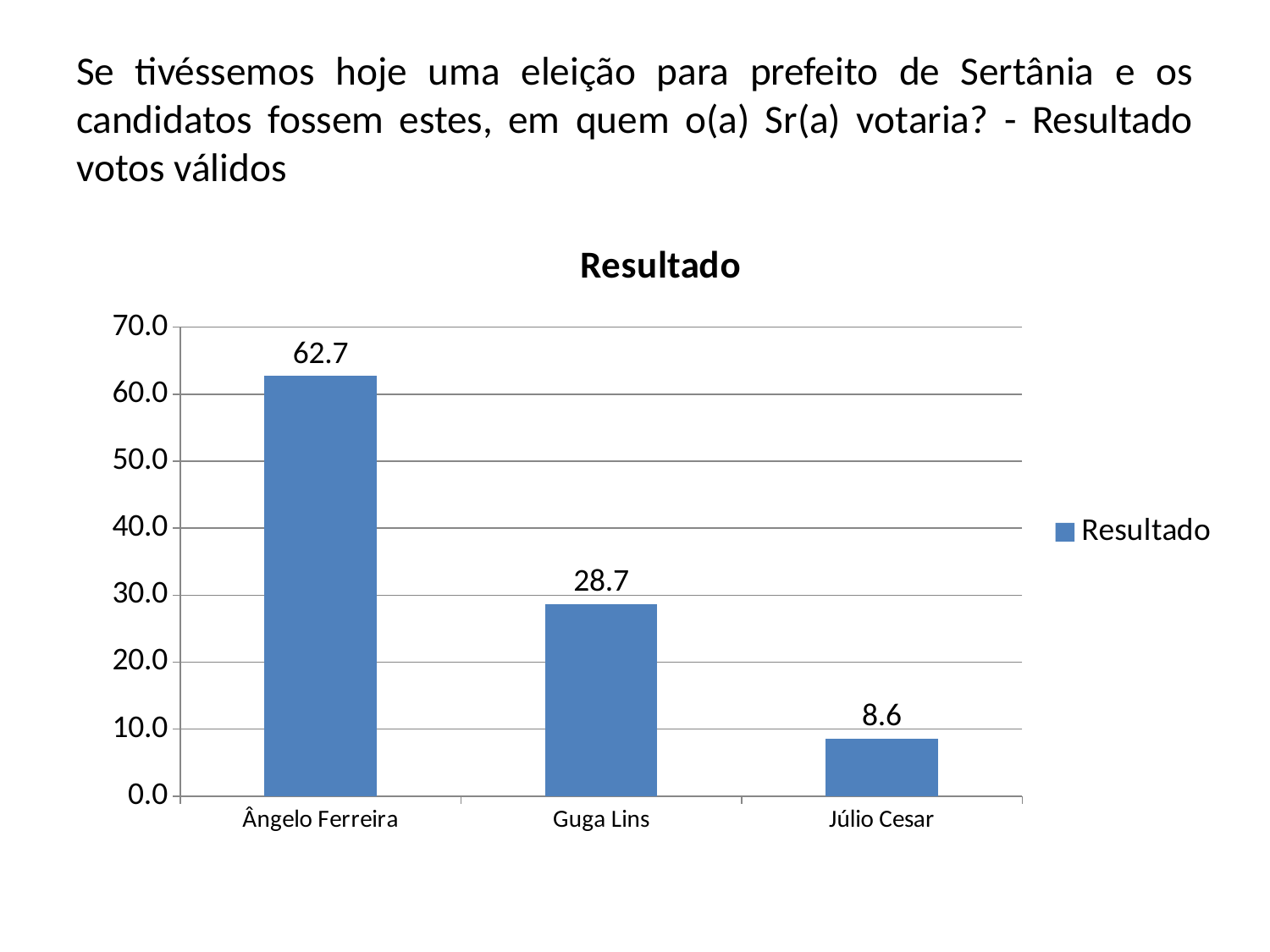
What kind of chart is shown on the slide? bar chart Which candidate has the highest value? Ângelo Ferreira What is the difference between the values for Guga Lins and Júlio Cesar? 20.1 What is the value for Guga Lins? 28.7 What is the value for Ângelo Ferreira? 62.7 What is the title of the chart? Resultado How many candidates are shown in the chart? 3 Which candidate has the lowest value? Júlio Cesar Is the value for Ângelo Ferreira greater or less than 60.0? greater What is the value for Júlio Cesar? 8.6 Which is larger, the value for Guga Lins or the value for Júlio Cesar? Guga Lins What is the difference between the values for Ângelo Ferreira and Guga Lins? 34.0